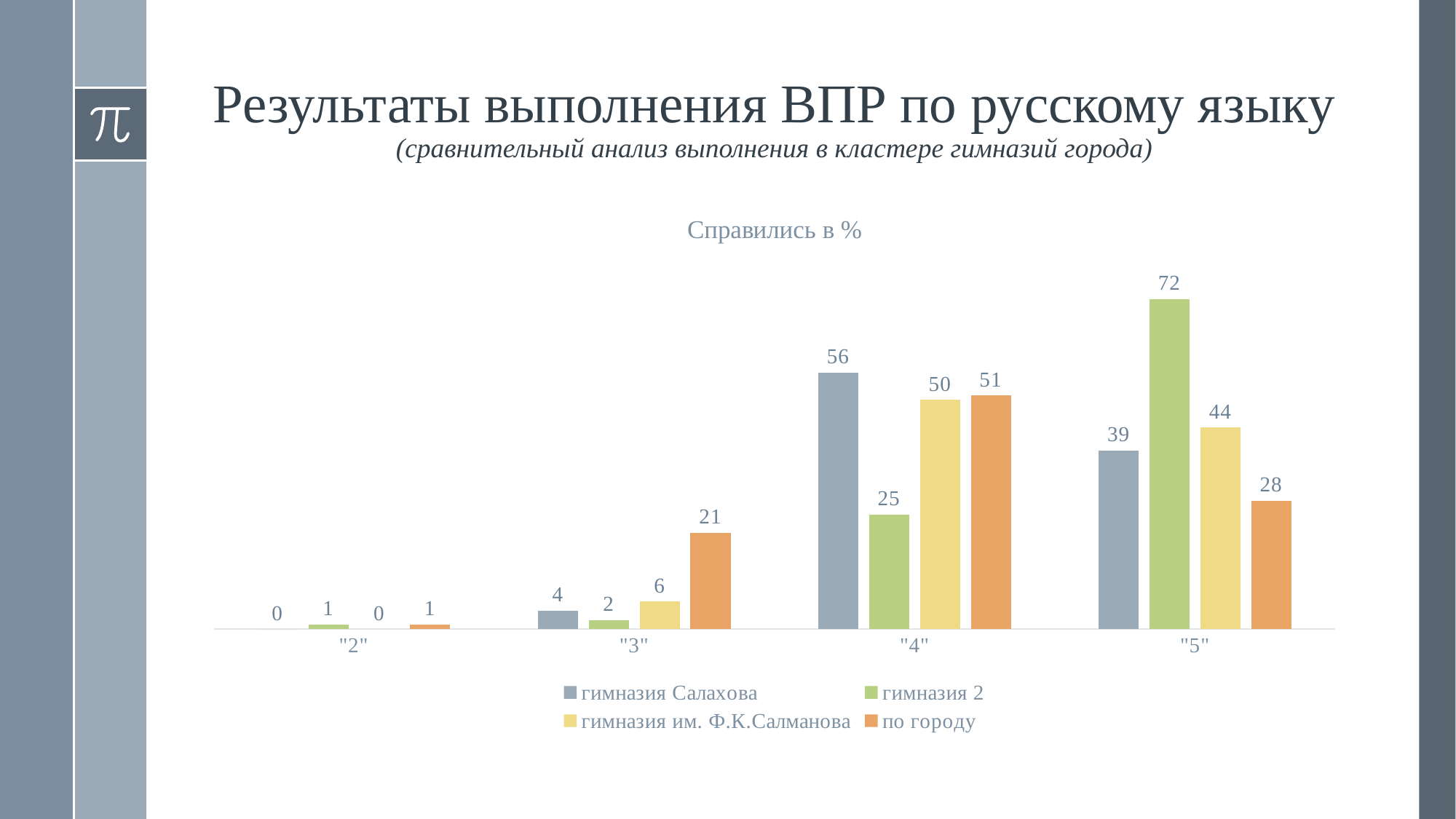
What is the value for гимназия 2 in the "5" category? 72 What is the difference between гимназия 2 and по городу in the "5" category? 44 What kind of chart is shown on the slide? bar chart What is the value for гимназия им. Ф.К.Салманова in the "4" category? 50 What is the value for гимназия Салахова in the "4" category? 56 Which series has the lowest value in the "4" category? гимназия 2 Which series has the highest value in the "5" category? гимназия 2 How many categories are shown on the x axis? 4 Which is larger in the "4" category: гимназия Салахова or по городу? гимназия Салахова What is the value for по городу in the "3" category? 21 What is the title of the chart? Справились в % How many series does the legend list? 4